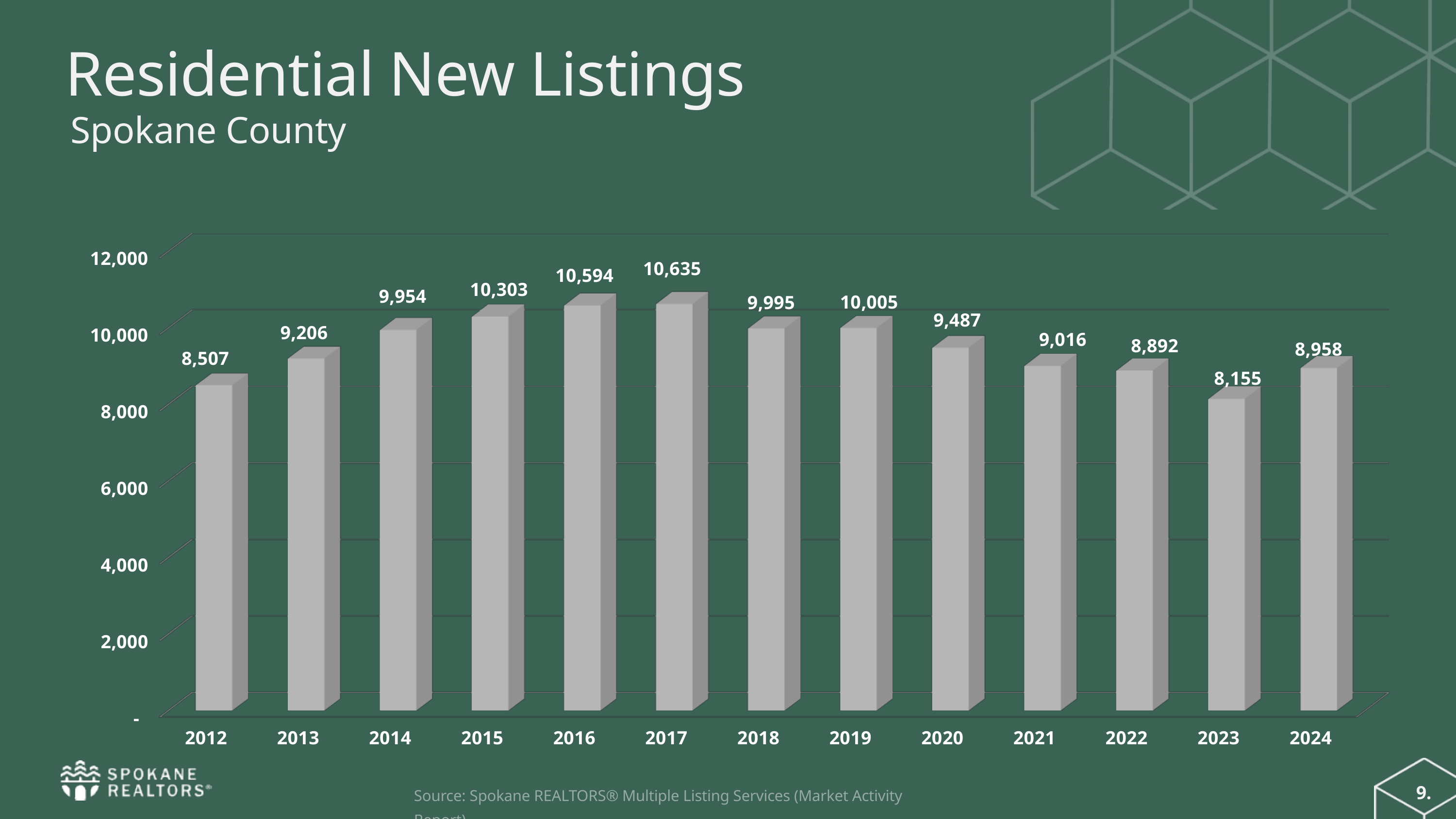
Did residential new listings rise or fall from 2017 to 2023? fall What was the number of residential new listings in 2023? 8,155 What kind of chart is shown on the slide? bar chart Which year had the highest number of residential new listings? 2017 What is the difference in residential new listings between 2024 and 2023? 803 How many years are shown on the x axis of the chart? 13 Which year had the lowest number of residential new listings? 2023 Is the value for 2016 greater or less than 10,000? greater What is the difference in residential new listings between 2017 and 2023? 2,480 What was the number of residential new listings in 2012? 8,507 What was the number of residential new listings in 2017? 10,635 Which year had more residential new listings, 2014 or 2020? 2014